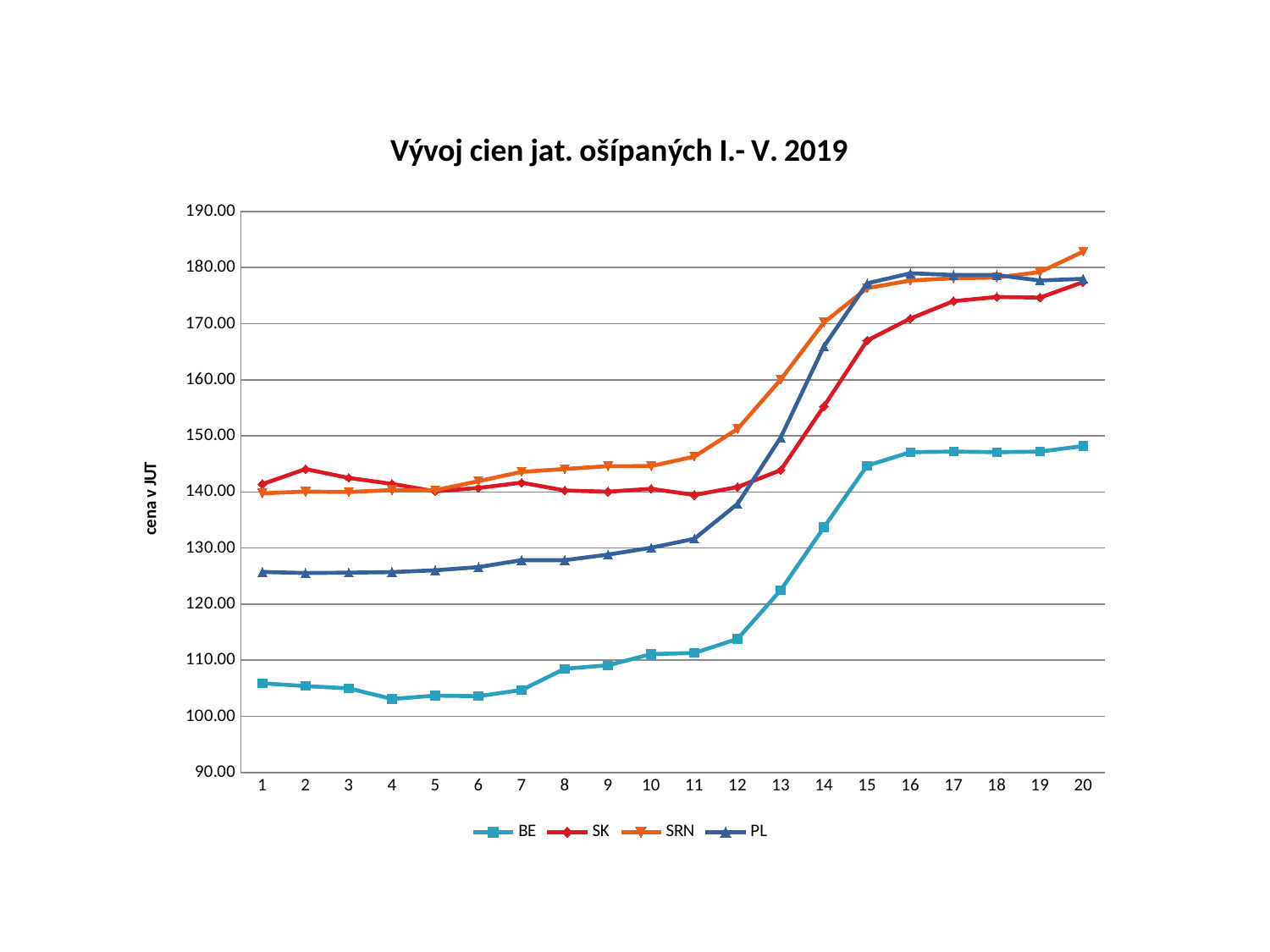
Is the value for SRN at point 20 greater or less than 180? greater What is the label on the vertical axis? cena v JUT How many series does the legend list? 4 What is the title of the chart? Vývoj cien jat. ošípaných I.- V. 2019 What kind of chart is shown on the slide? line chart How many points are plotted along the x axis for each series? 20 At point 20, which is larger, the value for SRN or the value for SK? SRN Is the value for BE at point 1 greater or less than 100? greater Do the values for BE rise or fall from point 1 to point 20? rise Is the value for BE at point 20 greater or less than 150? less Which series has the lowest value at point 10? BE